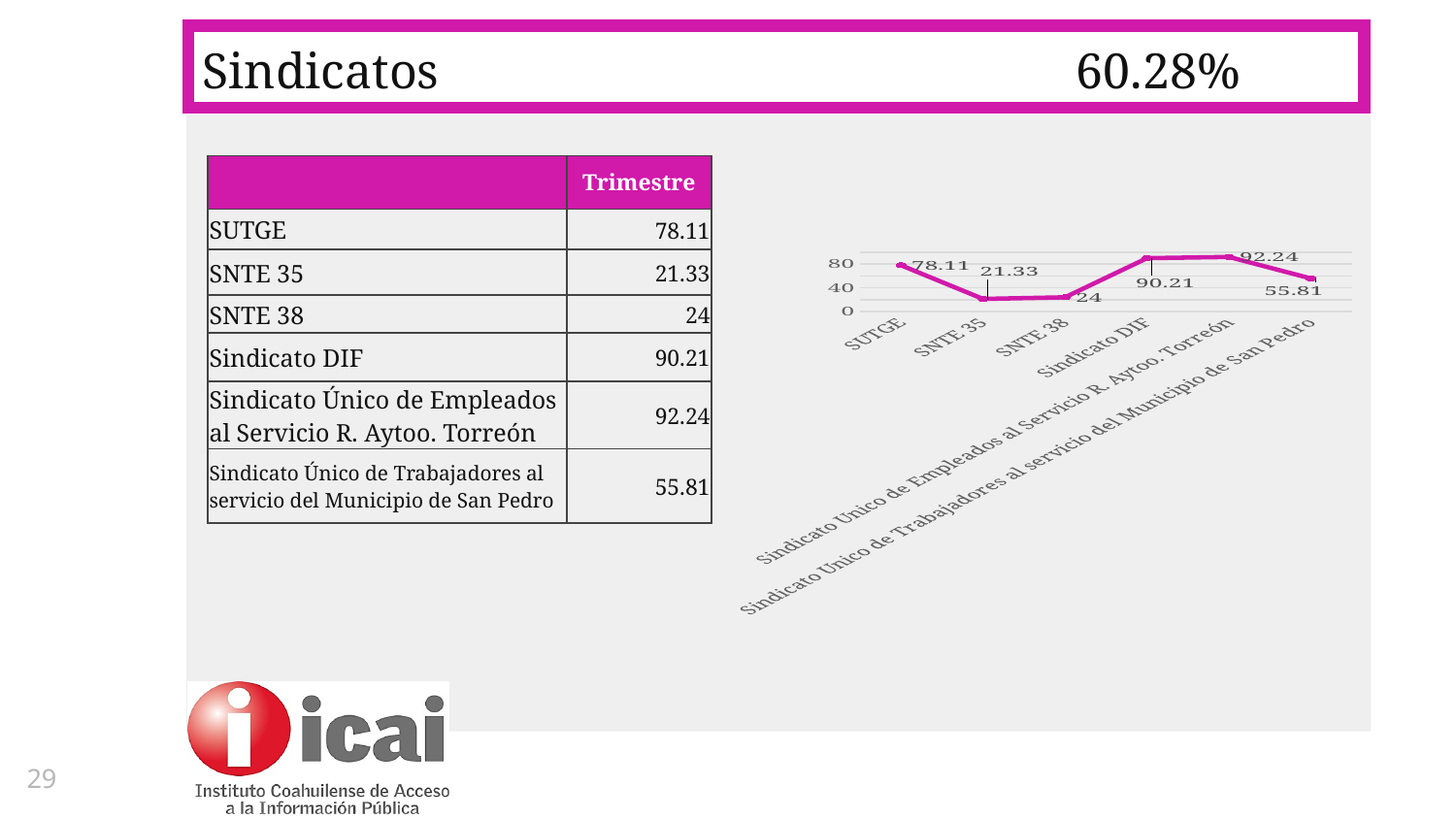
Which is larger, the value for SUTGE or the value for Sindicato DIF? Sindicato DIF What is the value for SUTGE in the chart? 78.11 Which category has the lowest value in the chart? SNTE 35 Is the value for SNTE 38 greater or less than 40? less What is the value for Sindicato Único de Trabajadores al servicio del Municipio de San Pedro in the chart? 55.81 Which category has the highest value in the chart? Sindicato Único de Empleados al Servicio R. Aytoo. Torreón What is the highest value shown on the chart's vertical axis? 80 What is the difference between the values for Sindicato DIF and SNTE 38? 66.21 What is the value for SNTE 35 in the chart? 21.33 What is the value for Sindicato DIF in the chart? 90.21 How many categories are plotted in the chart? 6 What kind of chart is shown on the slide? line chart